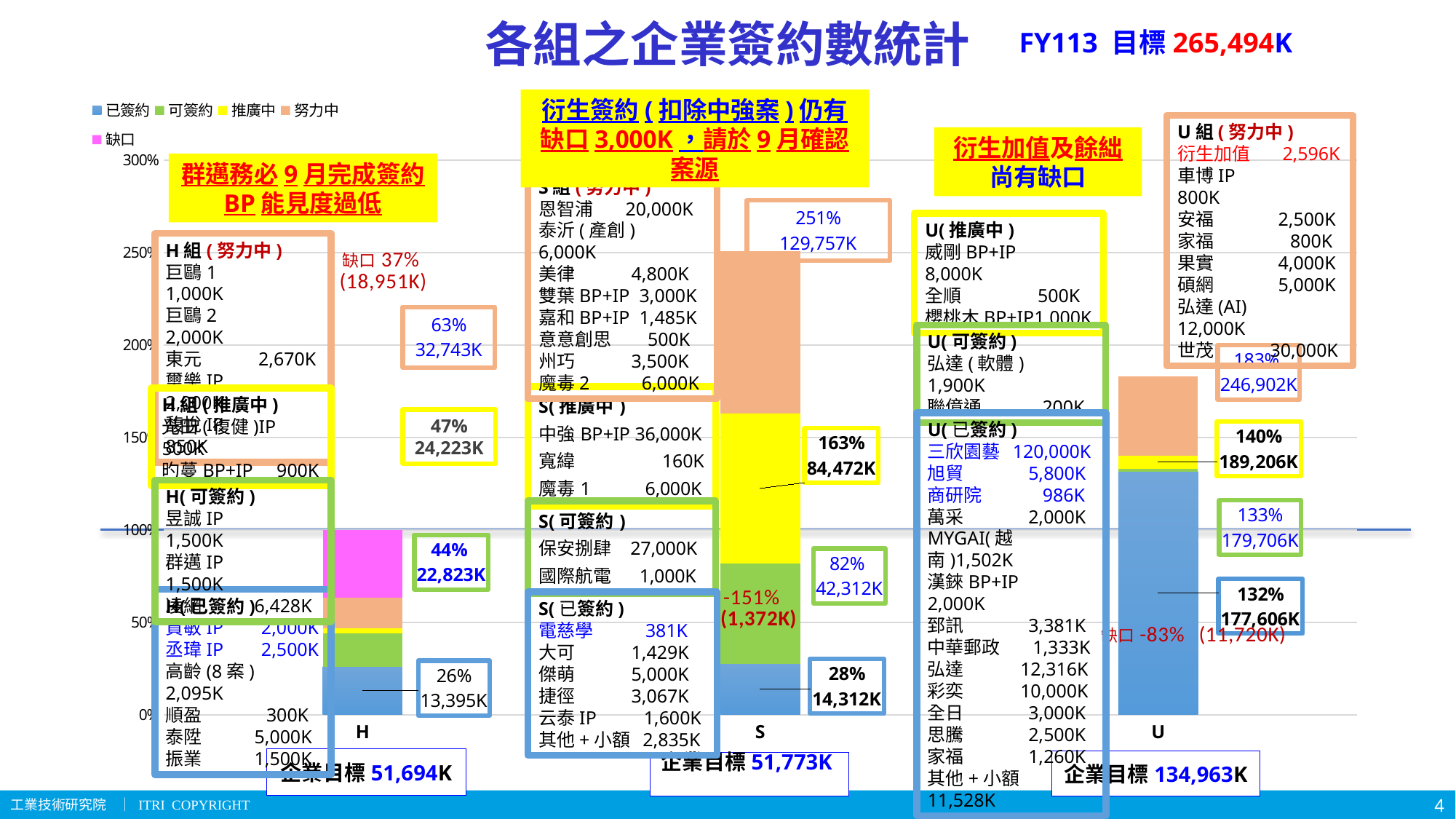
What is the 已簽約 value labelled for group S? 14,312K Which is larger, the 已簽約 value for U or for S? U What kind of chart is shown on the slide? bar chart How many groups (categories) are plotted on the x axis of the chart? 3 Which group has the lowest 已簽約 value? H Which group has the highest 已簽約 value? U What percentage is labelled for the 已簽約 segment of group H? 26% How many series does the chart legend list? 5 What percentage is labelled for the 已簽約 segment of group U? 132% What is the 已簽約 value labelled for group U? 177,606K What is the difference between the 已簽約 value for U (177,606K) and for S (14,312K)? 163,294K What is the 已簽約 value labelled for group H? 13,395K